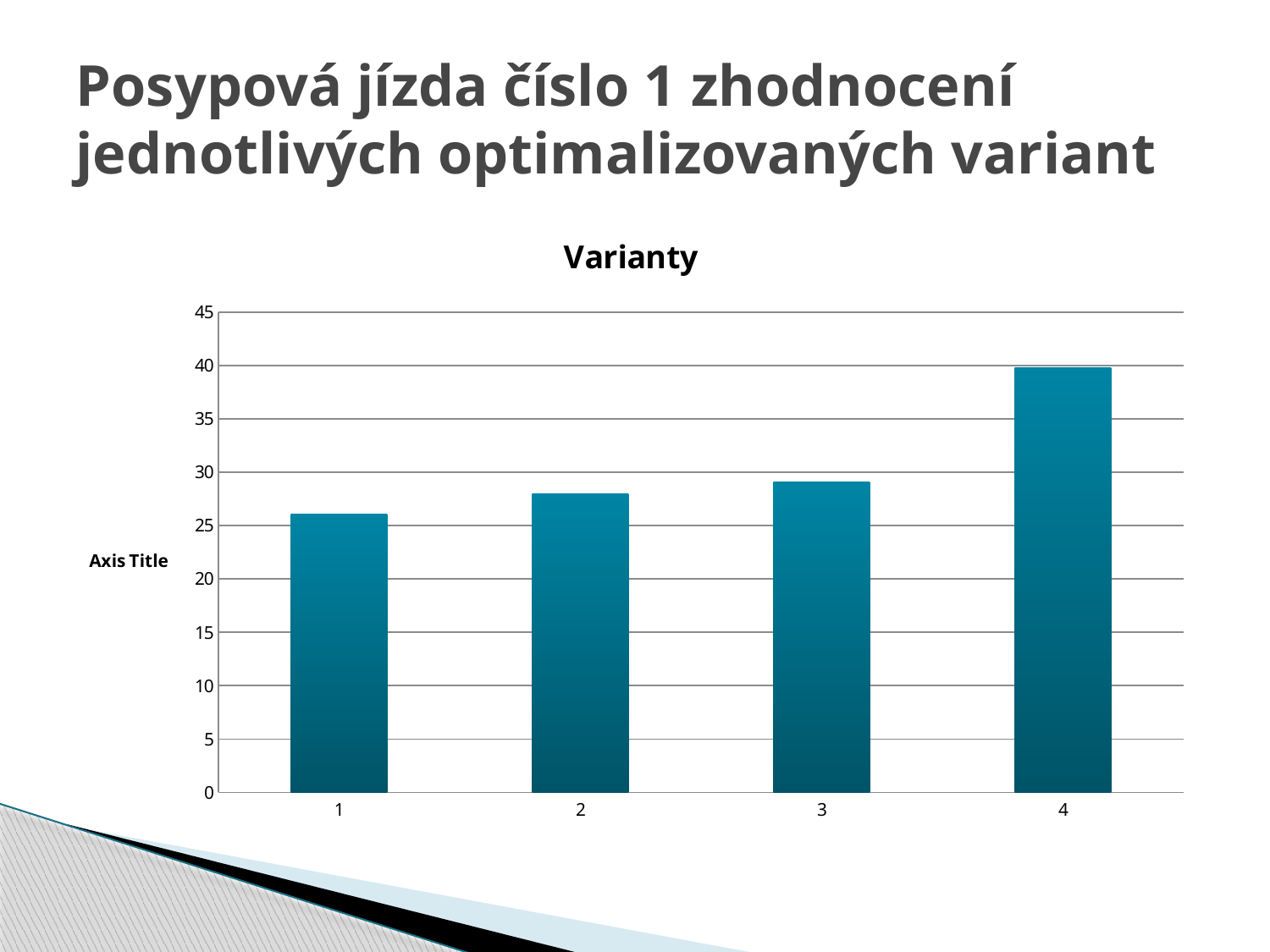
Which is larger, the value for category 4 or the value for category 1? category 4 Is the value for category 2 greater or less than 30? less What is the title of the chart? Varianty Is the value for category 3 greater or less than 25? greater Which category has the lowest bar? 1 Do the values rise or fall from category 1 to category 4? rise Is the value for category 1 greater or less than 30? less Which category has the highest bar? 4 What kind of chart is shown on the slide? bar chart How many bars (categories) does the chart show? 4 What is the label shown on the vertical axis? Axis Title